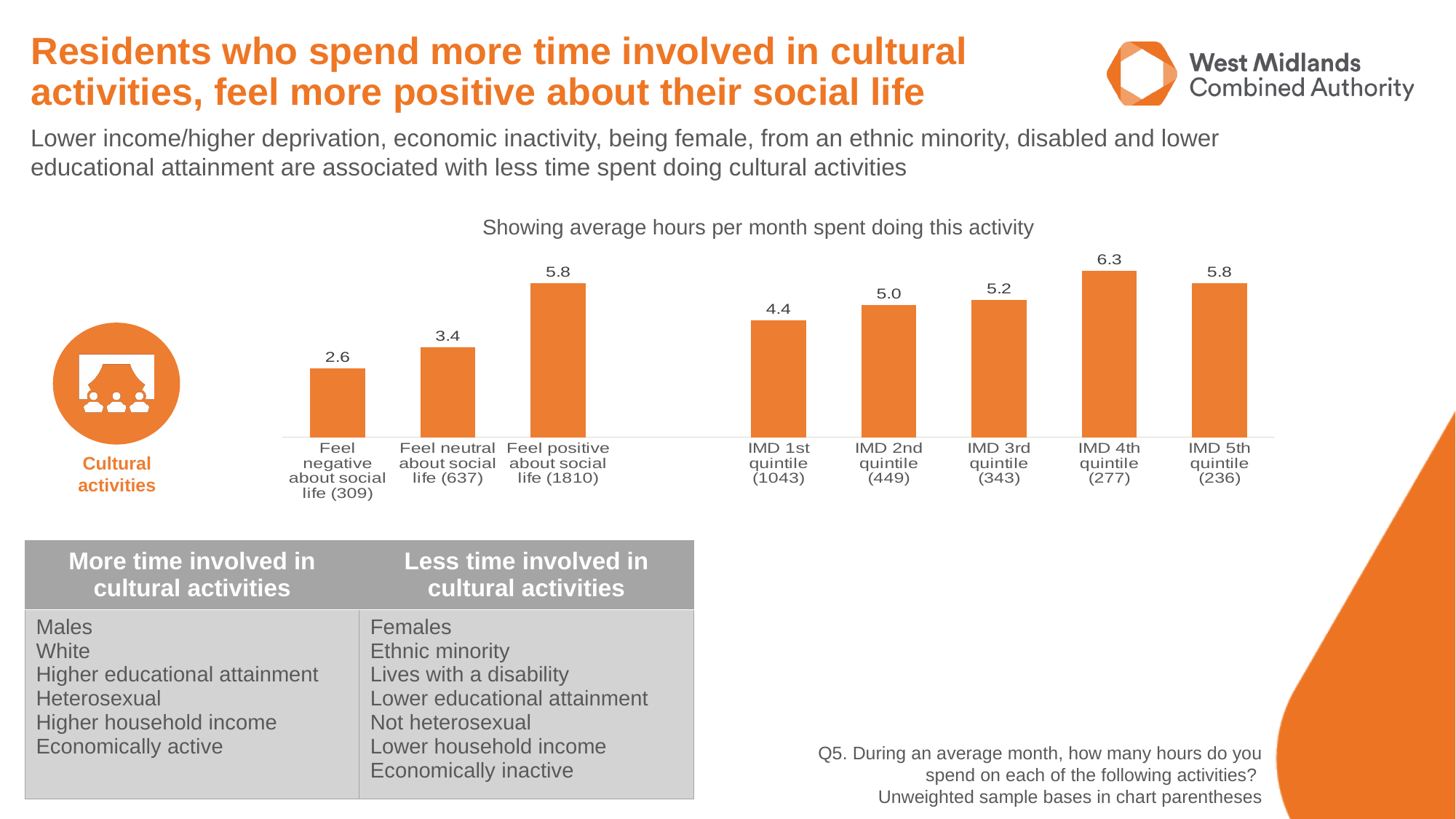
In the left chart (social life), what is the average hours per month for residents who feel negative about social life? 2.6 In the right chart (IMD quintiles), how many quintile categories are plotted? 5 In the right chart (IMD quintiles), which quintile has the lowest value? IMD 1st quintile In the right chart (IMD quintiles), which is larger, the value for IMD 2nd quintile or IMD 3rd quintile? IMD 3rd quintile In the left chart (social life), what is the value for residents who feel positive about social life? 5.8 In the left chart (social life), how many categories are shown? 3 In the left chart (social life), what is the difference between the values for feeling positive and feeling negative about social life? 3.2 In the left chart (social life), which category has the highest value? Feel positive about social life In the right chart (IMD quintiles), which quintile has the highest value? IMD 4th quintile What type of chart is used on this slide to show average hours per month? Bar chart In the right chart (IMD quintiles), what is the difference between the values for IMD 5th quintile and IMD 1st quintile? 1.4 In the right chart (IMD quintiles), what is the value for IMD 4th quintile? 6.3